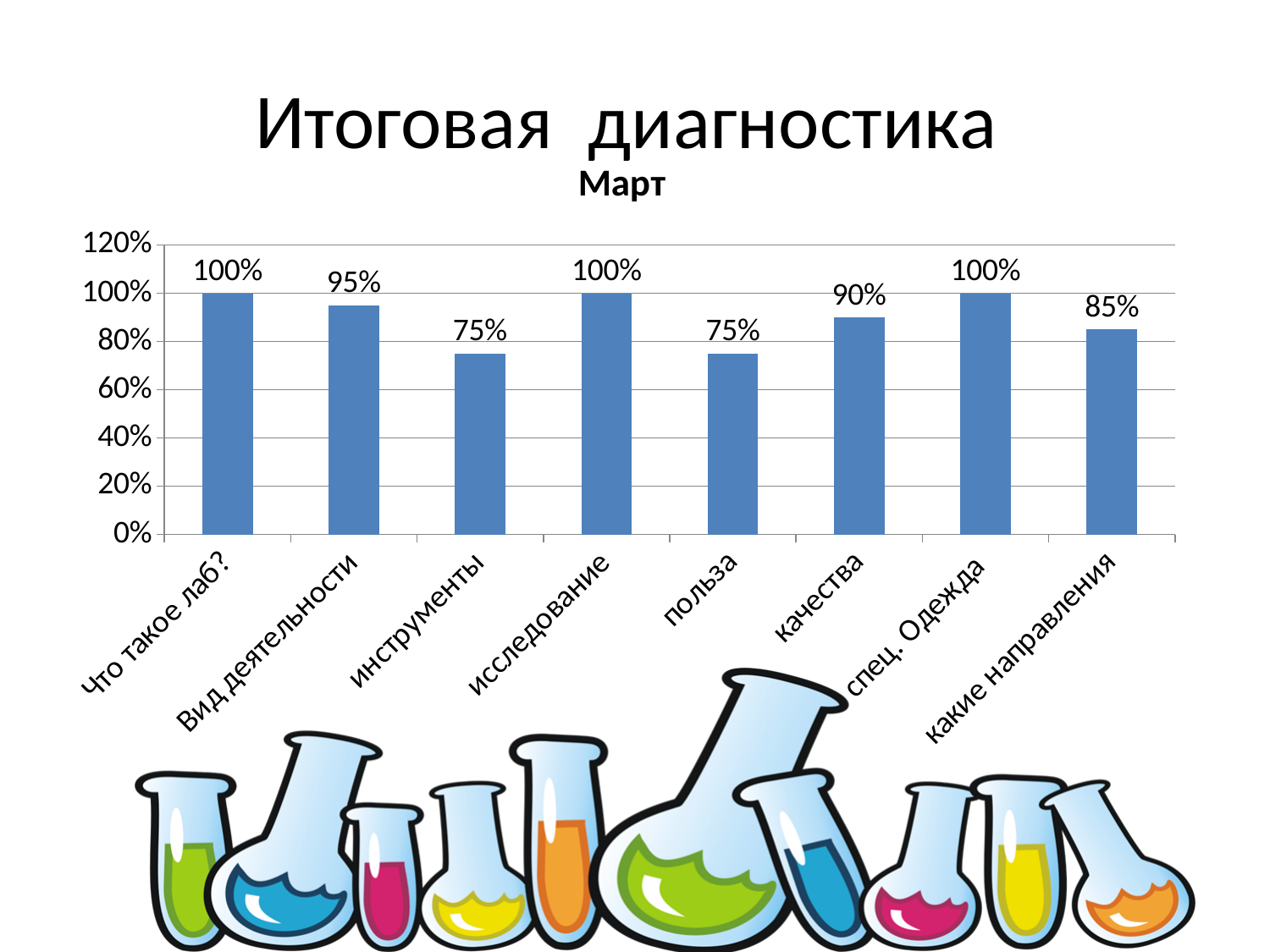
What is the value for "спец. Одежда"? 100% What is the difference between the values for "Вид деятельности" and "какие направления"? 10% What is the value for "Вид деятельности"? 95% Which is larger, the value for "качества" or the value for "какие направления"? качества What is the title of the chart? Март What is the value for "качества"? 90% How many categories are shown in the chart? 8 What kind of chart is shown on the slide? bar chart What is the value for "какие направления"? 85% What is the value for "инструменты"? 75% What is the lowest value shown in the chart? 75% What is the difference between the values for "исследование" and "польза"? 25%